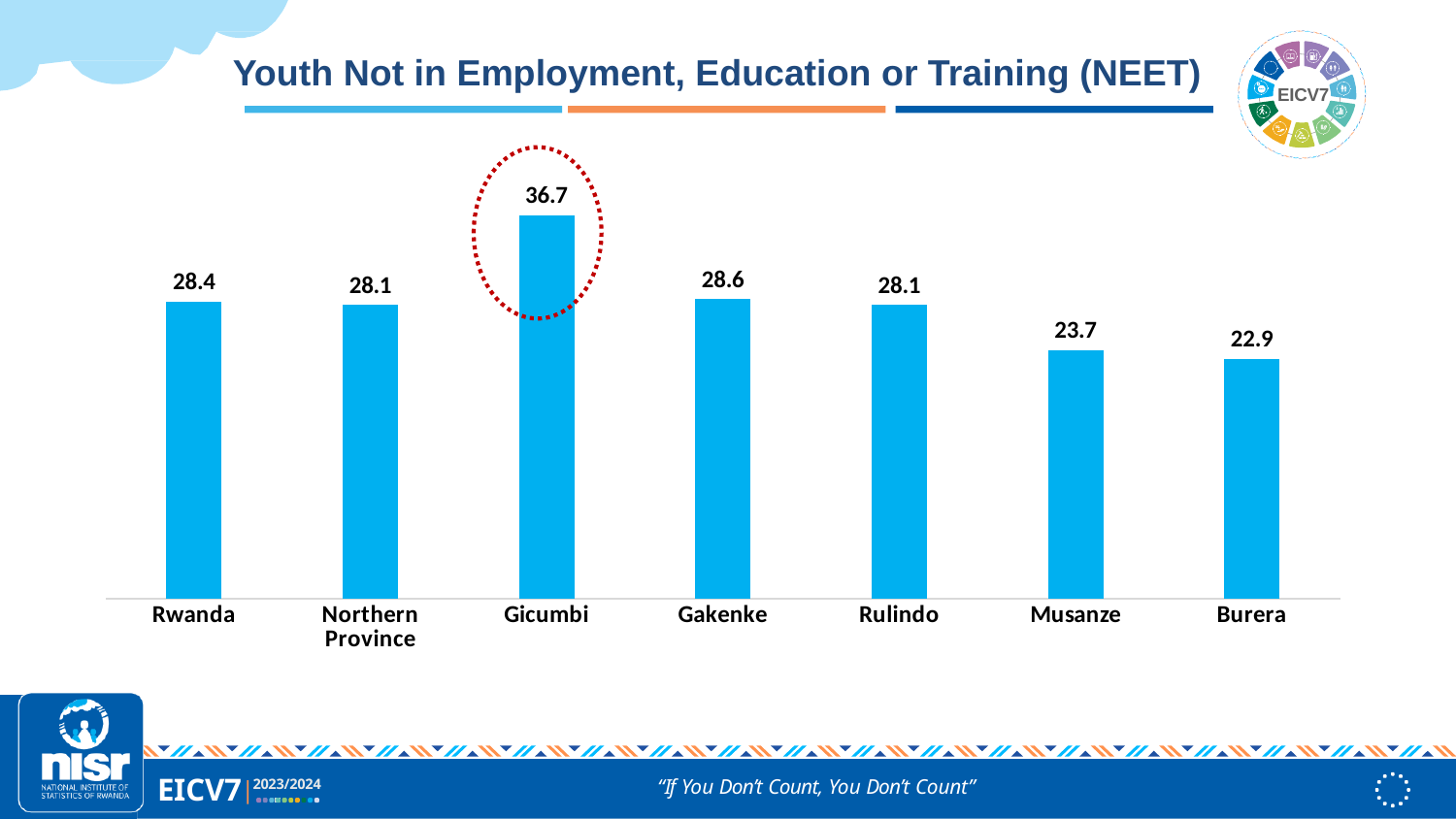
What is the difference between the NEET values for Musanze and Burera? 0.8 What is the NEET value for Musanze? 23.7 What is the difference between the NEET values for Gicumbi and Rwanda? 8.3 How many categories are shown on the chart? 7 What is the title of the chart? Youth Not in Employment, Education or Training (NEET) What is the NEET value for Gicumbi? 36.7 Which category has the lowest NEET value? Burera What is the NEET value for Rwanda? 28.4 What is the NEET value for Burera? 22.9 Which has a higher NEET value, Gakenke or Musanze? Gakenke Which category has the highest NEET value? Gicumbi What kind of chart is shown on the slide? Bar chart